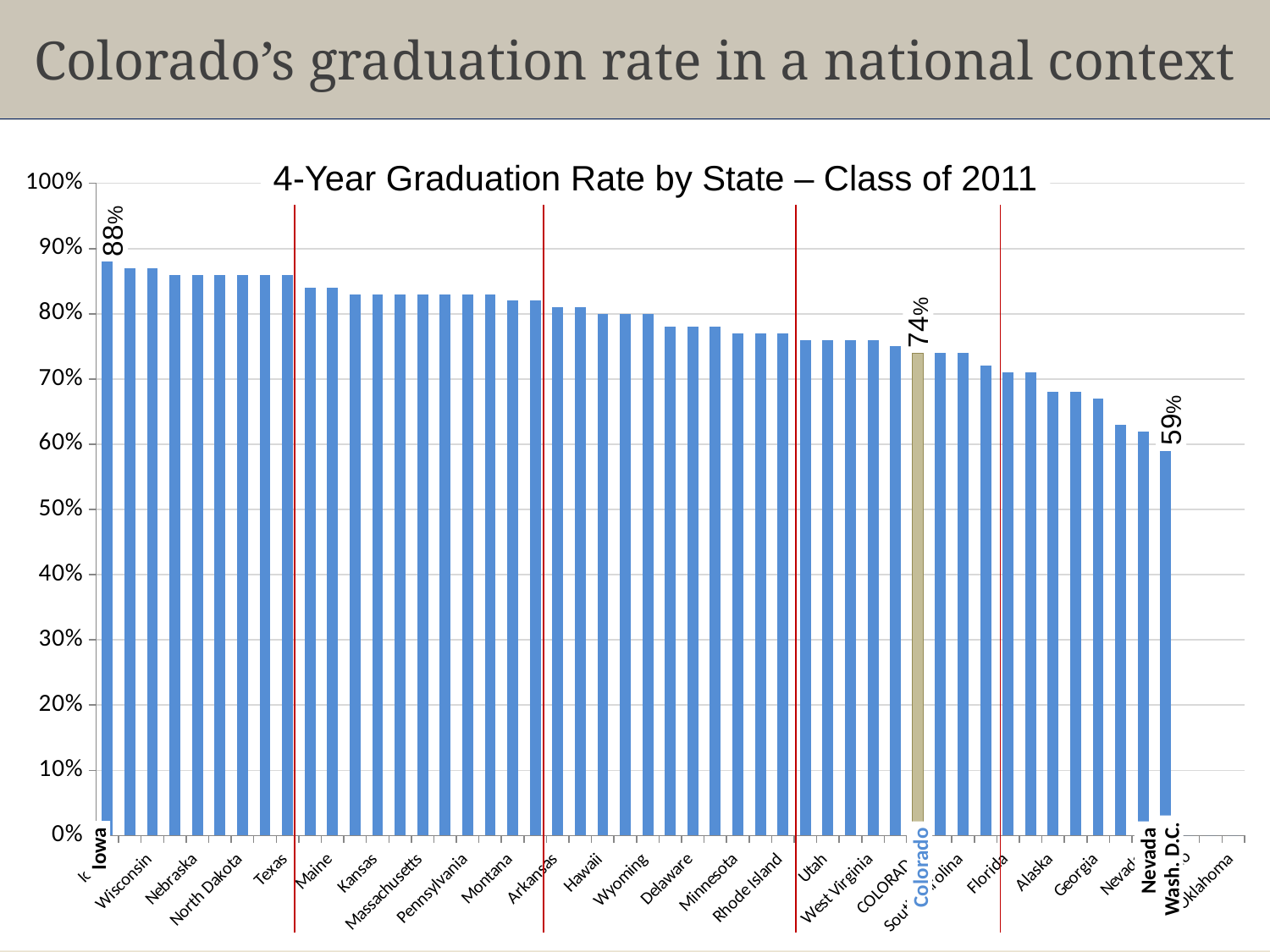
Which state has the highest 4-year graduation rate on the chart? Iowa Do the graduation rates rise or fall moving from left to right across the chart? Fall Which bar shows the lowest 4-year graduation rate on the chart? Wash. D.C. What is the 4-year graduation rate shown for Wash. D.C.? 59% Which has the higher graduation rate, Colorado or Wash. D.C.? Colorado What is the 4-year graduation rate shown for Iowa? 88% Is the graduation rate for Florida greater or less than 80%? less Is the graduation rate for Texas greater or less than 80%? greater How many percentage points higher is Colorado's graduation rate than Wash. D.C.'s? 15 percentage points How many percentage points higher is Iowa's graduation rate than Colorado's? 14 percentage points What is the 4-year graduation rate shown for Colorado? 74% What kind of chart is shown on the slide? Bar chart